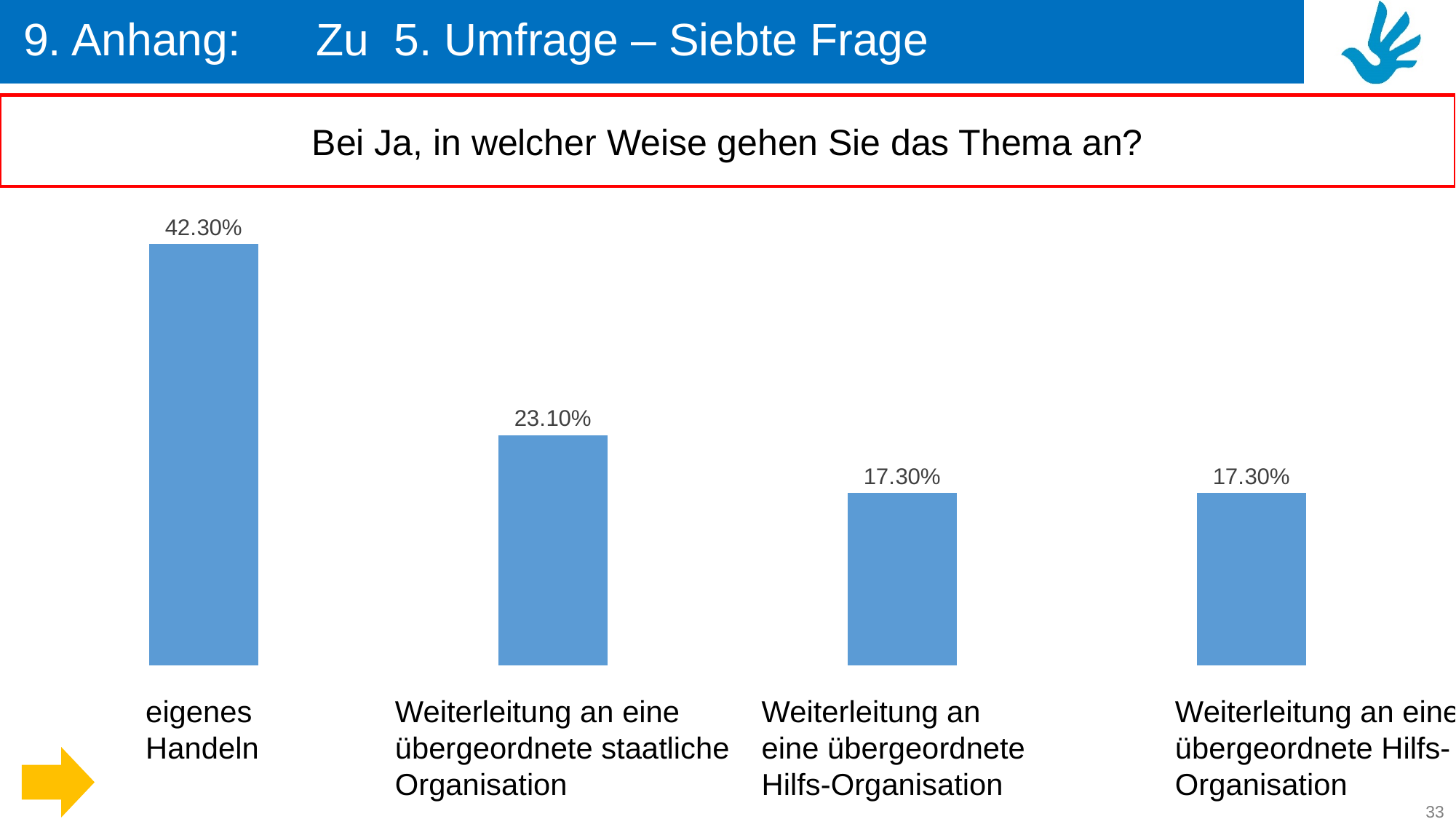
What is the value shown on the third bar from the left? 17.30% What is the value for "eigenes Handeln"? 42.30% Which is larger: the value for "eigenes Handeln" or the value for "Weiterleitung an eine übergeordnete staatliche Organisation"? eigenes Handeln What is the lowest value shown in the chart? 17.30% What is the difference between the values for "eigenes Handeln" and "Weiterleitung an eine übergeordnete staatliche Organisation"? 19.20 percentage points What is the difference between the value for "eigenes Handeln" and the value of the rightmost bar? 25.00 percentage points What is the value for "Weiterleitung an eine übergeordnete staatliche Organisation"? 23.10% Which category has the highest value? eigenes Handeln Do the values rise or fall from left to right across the bars? fall (the last two bars are equal at 17.30%) What kind of chart is shown on the slide? bar chart How many bars are shown in the chart? 4 What is the value shown on the rightmost bar? 17.30%